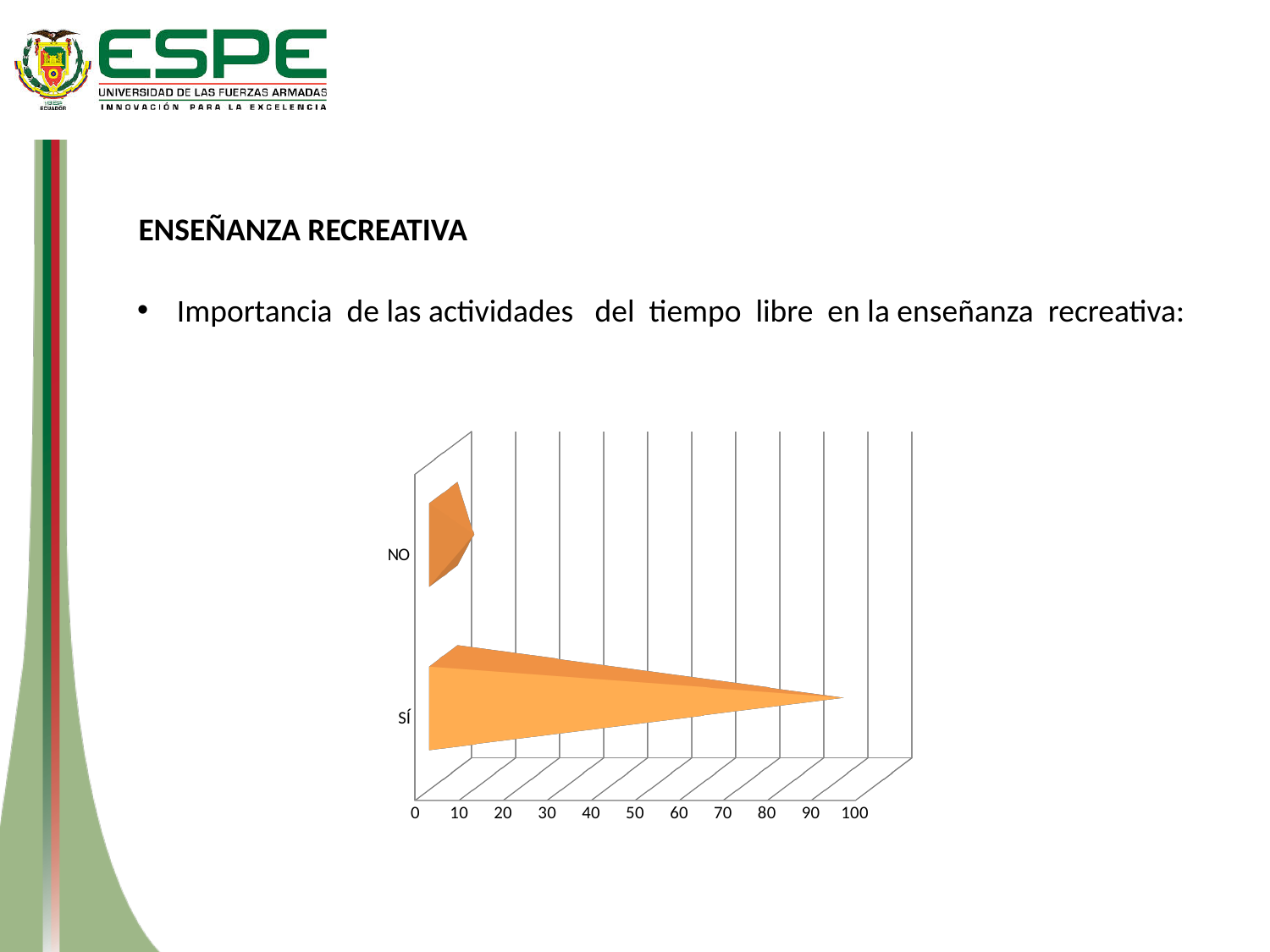
Which category has the lowest value on the chart? NO Which category has the highest value on the chart? SÍ Is the value for SÍ greater or less than 50? greater How many categories are shown on the chart? 2 What is the highest tick value shown on the horizontal axis of the chart? 100 What kind of chart is shown on the slide? bar chart Is the value for SÍ greater or less than 80? greater What are the two category labels on the vertical axis of the chart? NO and SÍ Is the value for NO greater or less than 50? less Which is larger, the value for SÍ or the value for NO? SÍ